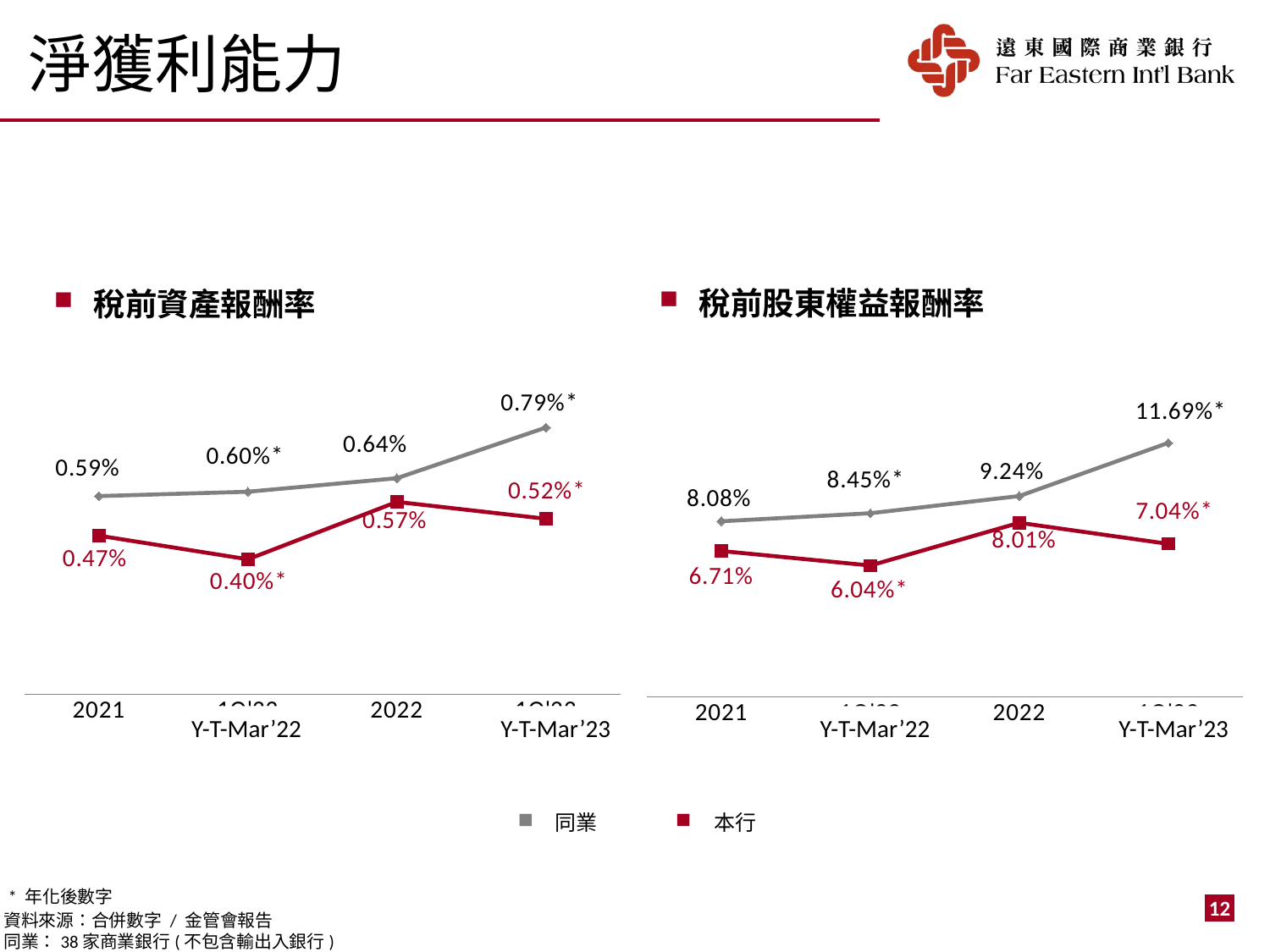
In the 稅前股東權益報酬率 chart, does the 同業 series rise or fall from 2021 to Y-T-Mar'23? Rise In the 稅前股東權益報酬率 chart, what is the difference between the 同業 and 本行 values for 2021? 1.37% In the 稅前股東權益報酬率 chart, what is the 同業 value for Y-T-Mar'23? 11.69%* In the 稅前股東權益報酬率 chart, at which x-axis point is the 本行 series lowest? Y-T-Mar'22 In the 稅前資產報酬率 chart, which series has the higher value for 2022, 同業 or 本行? 同業 How many series does the legend list? 2 In the 稅前資產報酬率 chart, what is the 本行 value for Y-T-Mar'23? 0.52%* In the 稅前股東權益報酬率 chart, what is the 本行 value for 2022? 8.01% What kind of chart is the 稅前資產報酬率 chart? Line chart In the 稅前資產報酬率 chart, at which x-axis point is the 同業 series highest? Y-T-Mar'23 In the 稅前資產報酬率 chart, what is the 同業 value for 2021? 0.59% How many x-axis points does the 稅前股東權益報酬率 chart have? 4